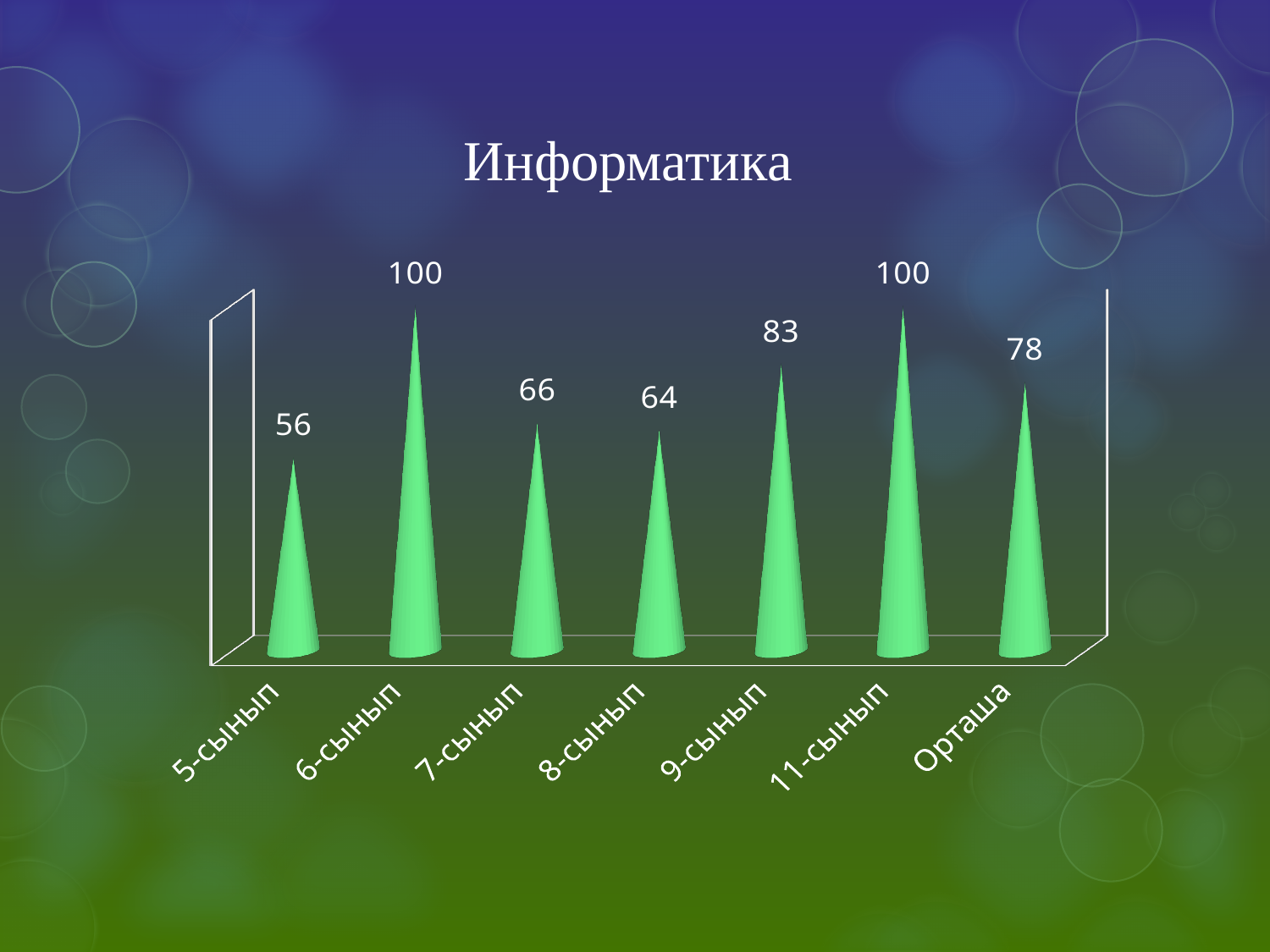
What kind of chart is shown on the slide? bar chart What is the value for 9-сынып? 83 What is the difference between the values for 9-сынып and 8-сынып? 19 What is the title of the chart? Информатика Which is larger, the value for 7-сынып or the value for 8-сынып? 7-сынып What is the value for 7-сынып? 66 Which category has the lowest value? 5-сынып What is the value for Орташа? 78 Which categories share the highest value? 6-сынып and 11-сынып What is the value for 5-сынып? 56 What is the difference between the values for 6-сынып and 5-сынып? 44 How many categories are shown on the x axis? 7